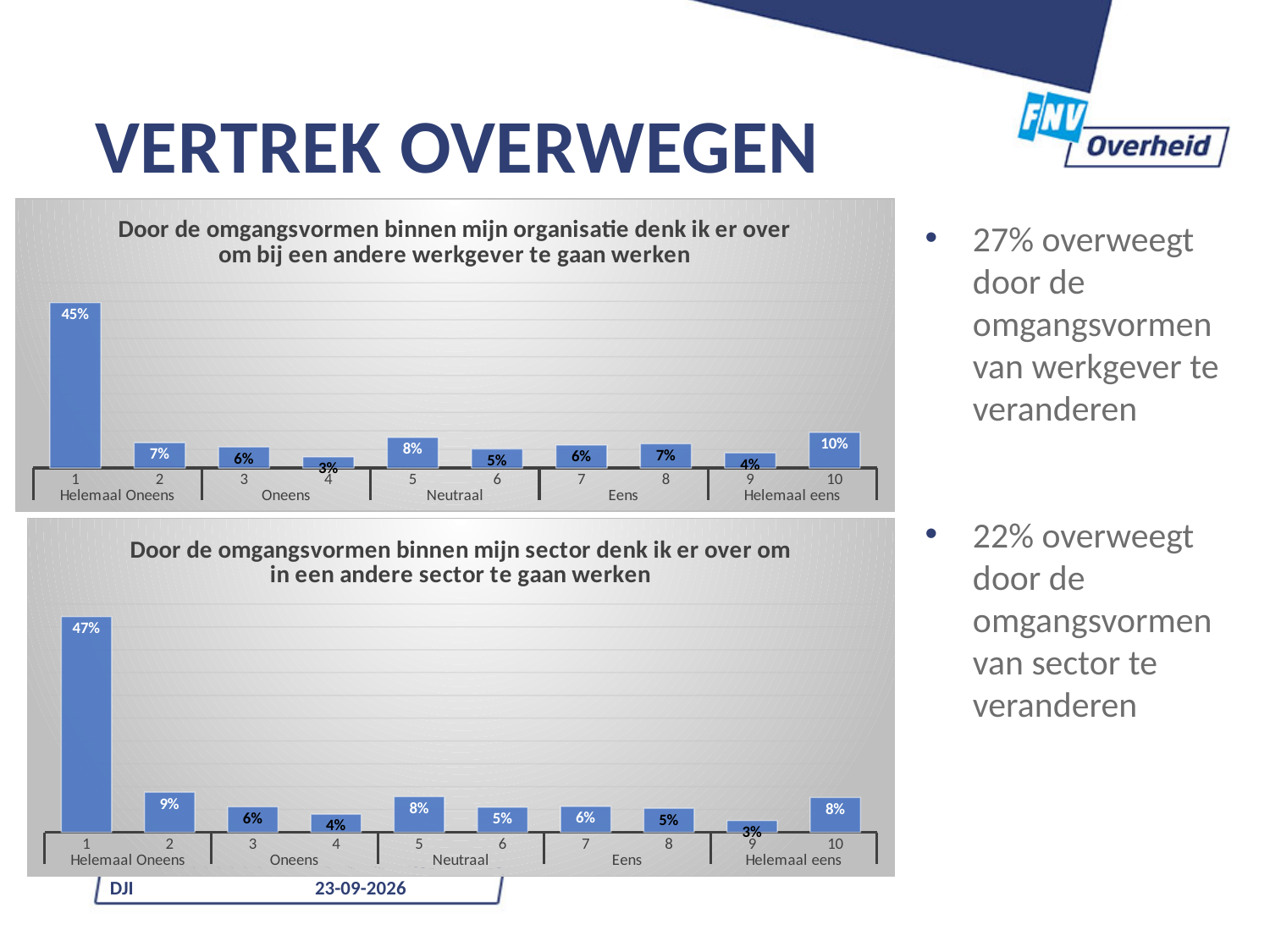
In the top chart (organisatie / andere werkgever), how many categories are plotted? 10 In the top chart (organisatie / andere werkgever), what is the difference between the values for category 1 and category 2? 38% In the bottom chart (sector / andere sector), which is larger: the value for category 5 or the value for category 9? category 5 In the bottom chart (sector / andere sector), which category has the lowest value? 9 In the top chart (organisatie / andere werkgever), what is the value for category 10? 10% What is the title of the top chart? Door de omgangsvormen binnen mijn organisatie denk ik er over om bij een andere werkgever te gaan werken In the bottom chart (sector / andere sector), what is the difference between the values for category 10 and category 9? 5% In the top chart (organisatie / andere werkgever), what is the value for category 1? 45% What kind of chart is the bottom chart (sector / andere sector)? bar chart In the bottom chart (sector / andere sector), what is the value for category 2? 9% In the top chart (organisatie / andere werkgever), which category has the lowest value? 4 In the bottom chart (sector / andere sector), what is the value for category 1? 47%